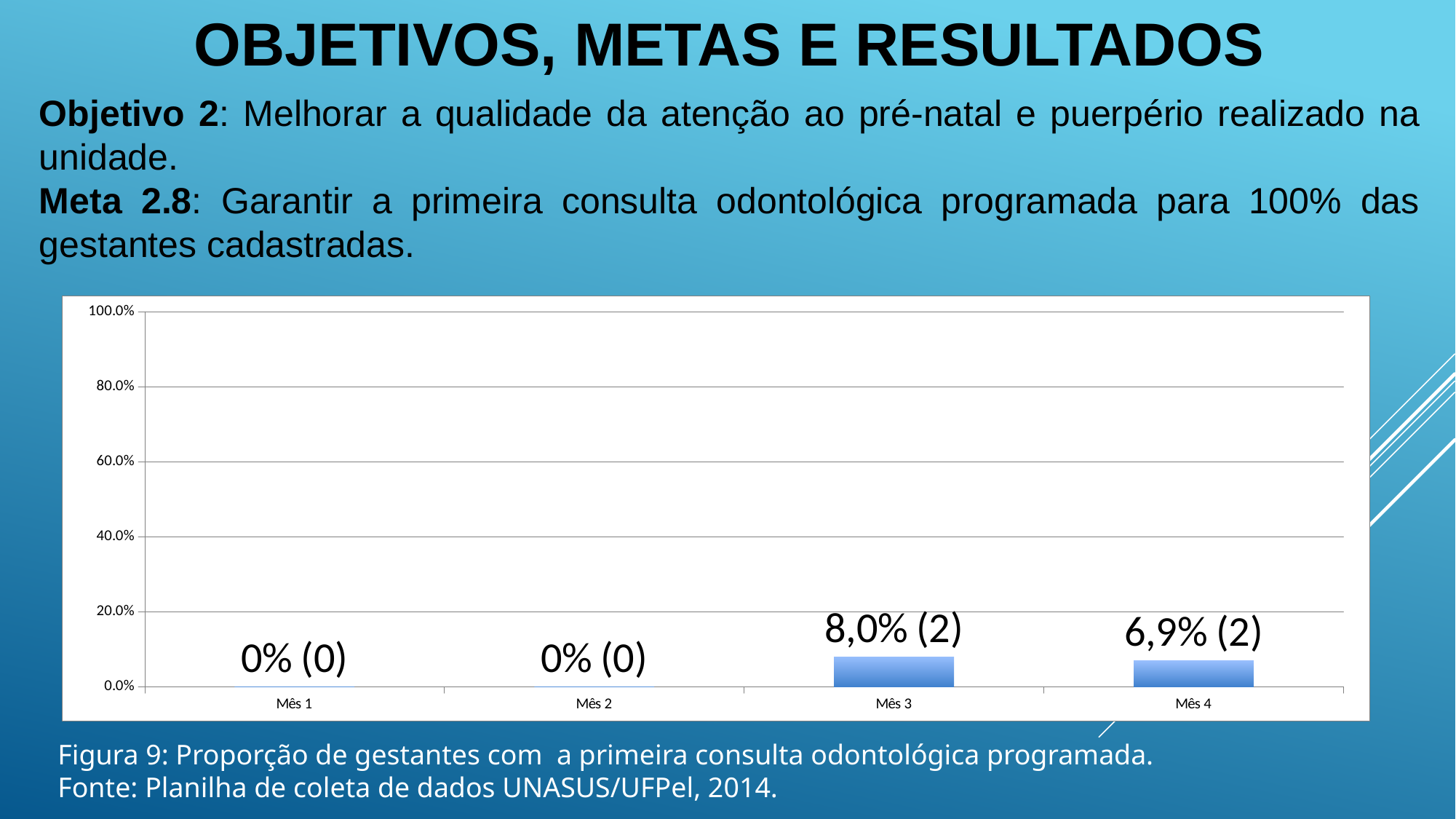
What is the difference in percentage points between Mês 3 and Mês 4? 1,1 What is the value shown for Mês 2? 0% (0) What is the value shown for Mês 3? 8,0% (2) Which is larger, the value for Mês 3 or the value for Mês 4? Mês 3 What is the value shown for Mês 4? 6,9% (2) What is the highest value shown on the y axis of the chart? 100.0% How many months (categories) are shown on the x axis of the chart? 4 What is the figure number given in the caption below the chart? Figura 9 What kind of chart is shown on the slide? bar chart Is the value for Mês 3 greater or less than 20.0%? less Which month has the highest value in the chart? Mês 3 What is the value shown for Mês 1? 0% (0)